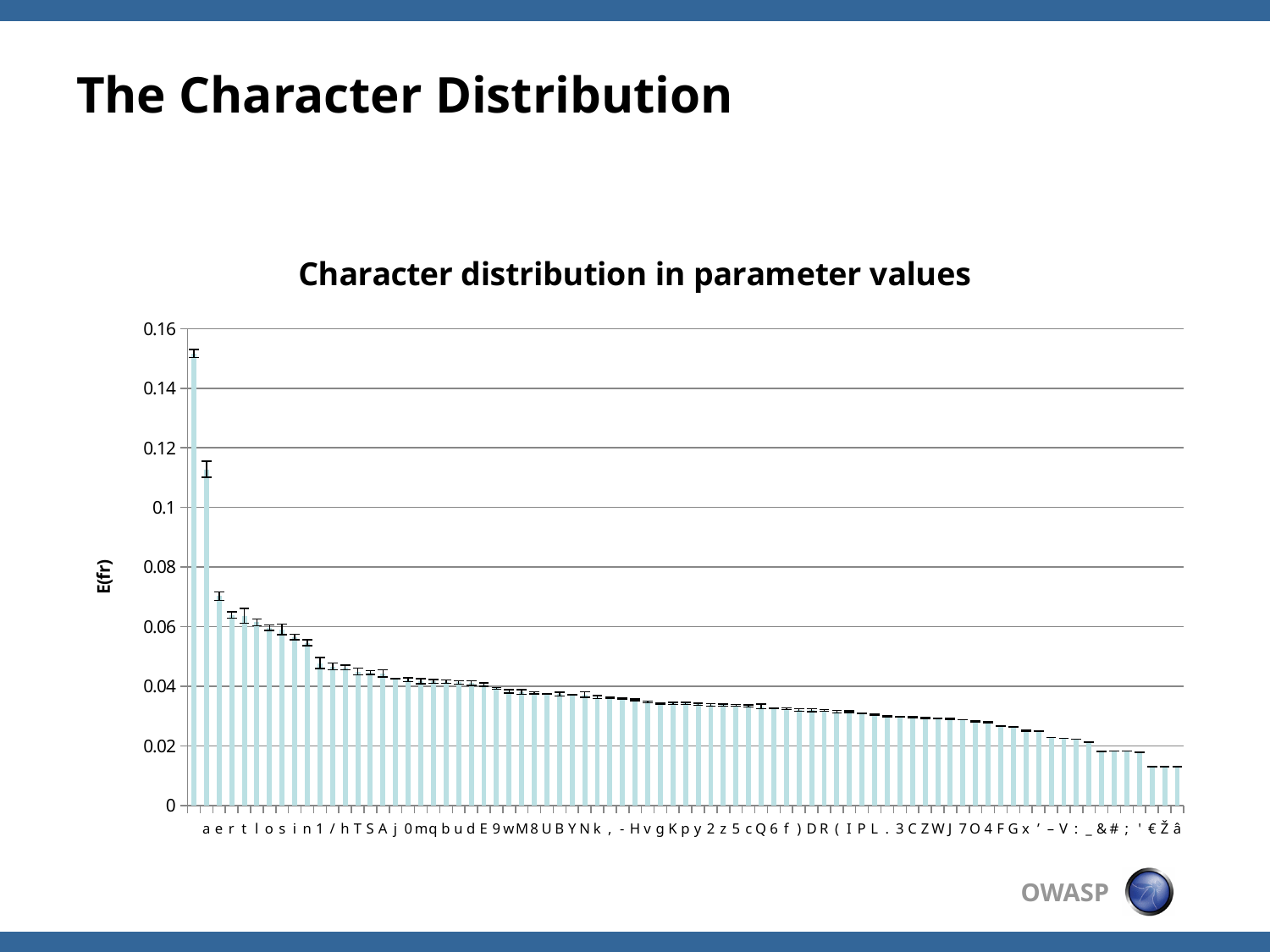
Is the value for the character 'e' greater or less than 0.1? less Is the value for the character 'r' greater or less than 0.06? greater What is the title of the chart? Character distribution in parameter values Is the value for the character 'r' greater or less than 0.08? less What is the label on the vertical axis of the chart? E(fr) Which has a larger value, the character 'a' or the character 'e'? a What kind of chart is shown on the slide? bar chart Do the values rise or fall moving from left to right along the x axis? fall